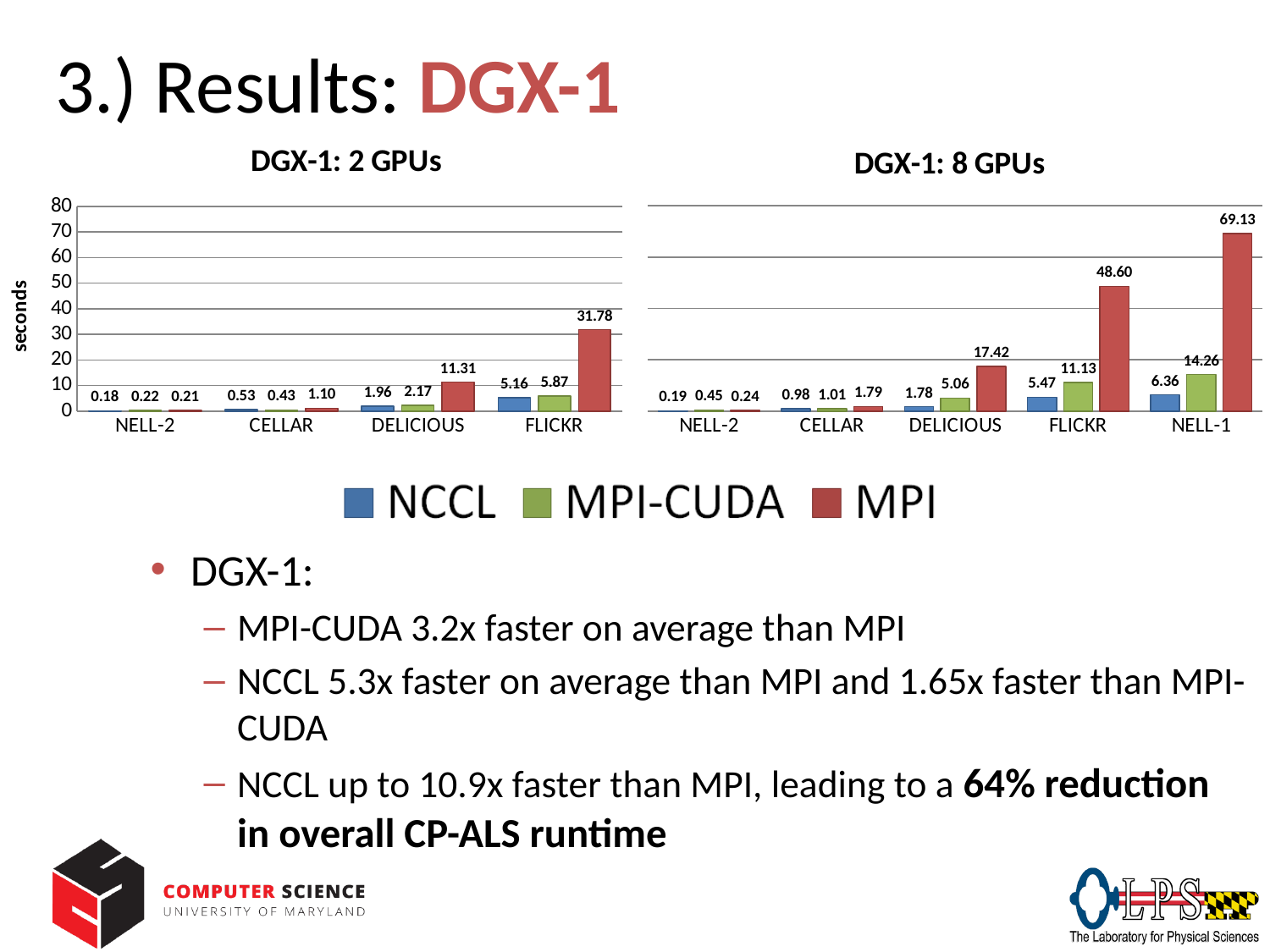
In the "DGX-1: 2 GPUs" chart, which category has the lowest NCCL value? NELL-2 How many series does the legend list? 3 In the "DGX-1: 8 GPUs" chart, which category has the highest MPI value? NELL-1 In the "DGX-1: 8 GPUs" chart, is the MPI value for NELL-1 greater or less than 60? greater In the "DGX-1: 8 GPUs" chart, what is the NCCL value for NELL-1? 6.36 In the "DGX-1: 8 GPUs" chart, which is larger for FLICKR: the MPI-CUDA value or the NCCL value? MPI-CUDA How many categories are shown on the x axis of the "DGX-1: 8 GPUs" chart? 5 In the "DGX-1: 8 GPUs" chart, what is the difference between the MPI values for NELL-1 and FLICKR? 20.53 In the "DGX-1: 8 GPUs" chart, what is the MPI-CUDA value for DELICIOUS? 5.06 In the "DGX-1: 2 GPUs" chart, what is the difference between the MPI and NCCL values for DELICIOUS? 9.35 In the "DGX-1: 2 GPUs" chart, what is the MPI value for FLICKR? 31.78 What type of chart is the "DGX-1: 2 GPUs" chart? Bar chart